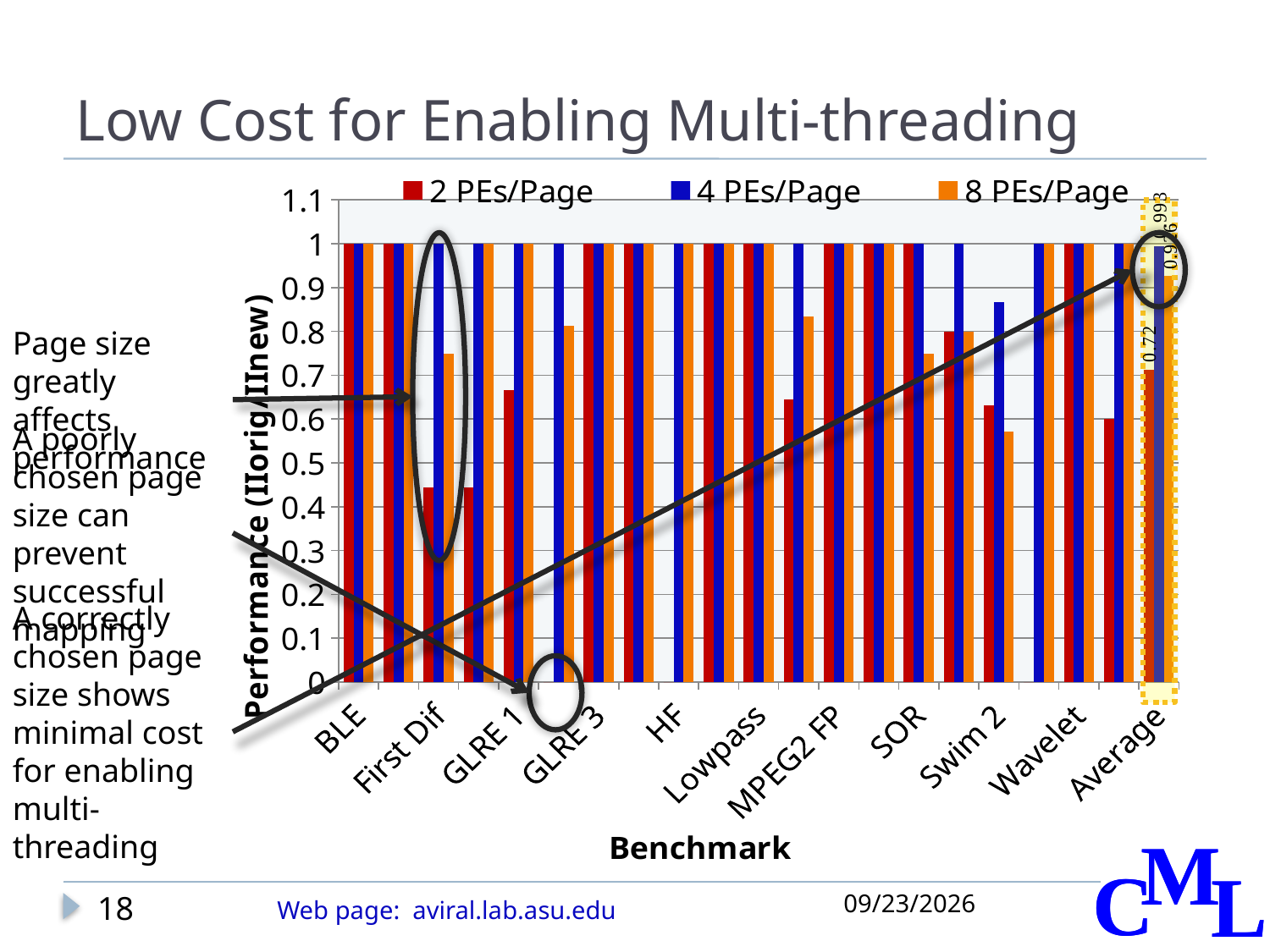
For Swim 2, which is larger: the 4 PEs/Page value or the 8 PEs/Page value? 4 PEs/Page What is the title of the vertical axis? Performance (IIorig/IInew) What is the 8 PEs/Page value for the Average category? 0.926 How many series does the legend list? 3 Which series has the lowest value for the Average category? 2 PEs/Page Is the 2 PEs/Page value for First Dif greater or less than 0.5? less What kind of chart is shown on the slide? bar chart Which colour represents the 8 PEs/Page series? orange What is the 2 PEs/Page value for the Average category? 0.72 Is the 8 PEs/Page value for First Dif greater or less than 0.6? greater For First Dif, which is larger: the 2 PEs/Page value or the 4 PEs/Page value? 4 PEs/Page Is the 4 PEs/Page value for Swim 2 greater or less than 0.8? greater